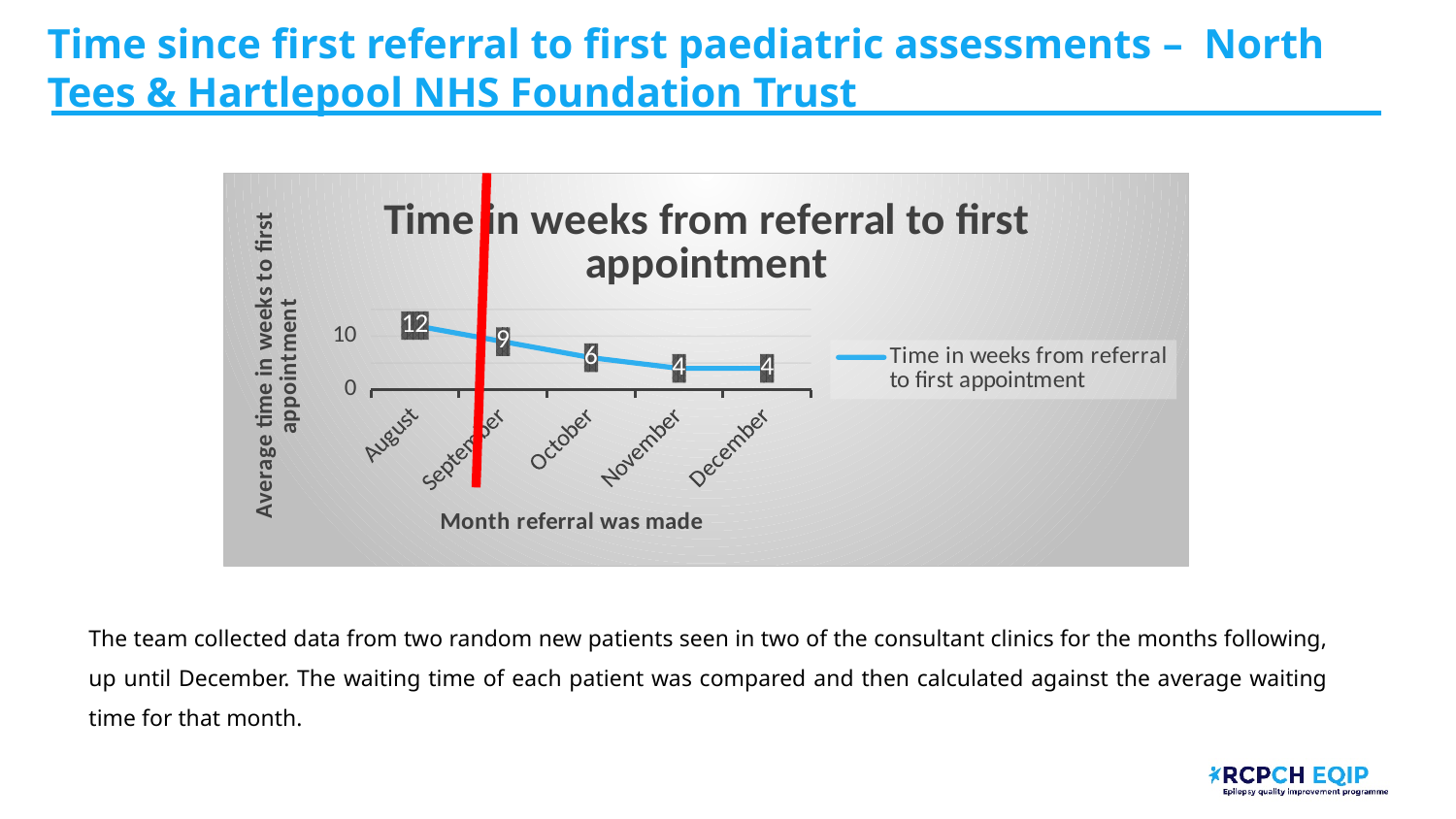
What is the difference between the values for August and December? 8 What is the value for August? 12 What is the value for October? 6 How many months are plotted on the x axis? 5 What is the value for September? 9 What kind of chart is shown? Line chart How many series does the legend list? 1 Do the values rise or fall from August to December? Fall What is the title of the chart? Time in weeks from referral to first appointment Which month has the highest value? August What is the difference between the values for September and October? 3 Which is larger, the value for September or the value for November? September